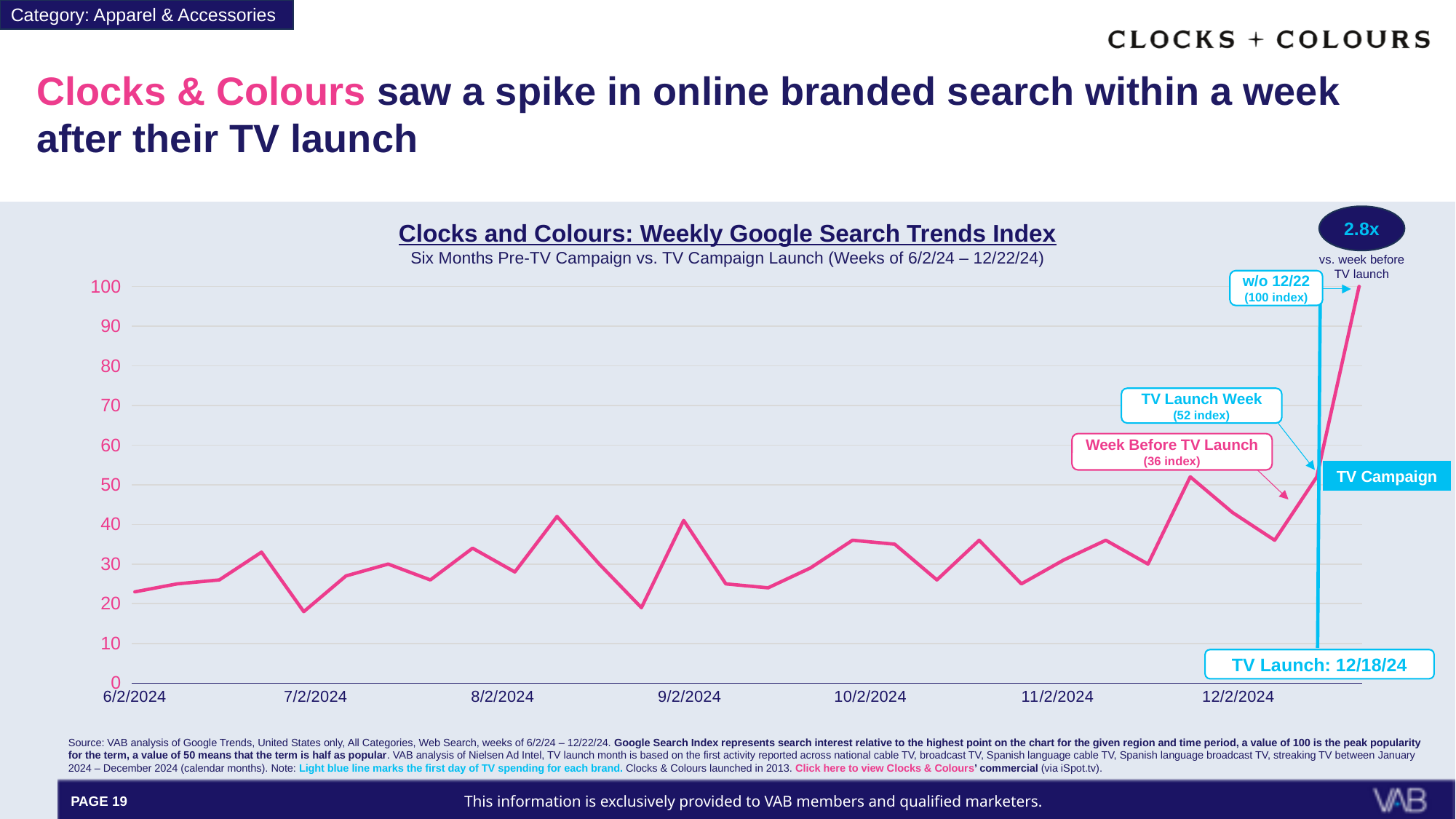
By how much does the TV Launch Week index exceed the Week Before TV Launch index? 16 What is the Google Search Trends index for the week of 12/22? 100 What kind of chart is shown on the slide? line chart Which week has the highest search index on the chart? w/o 12/22 What is the index value for the TV Launch Week? 52 What is the TV launch date marked on the chart? 12/18/24 Does the index rise or fall from the Week Before TV Launch to the week of 12/22? rises Which is larger, the index for the TV Launch Week or the Week Before TV Launch? TV Launch Week By what multiple did search increase vs. the week before TV launch, according to the callout? 2.8x What is the index value for the Week Before TV Launch? 36 Is the index value for 6/2/2024 greater or less than 30? less What is the difference between the index for the week of 12/22 and the Week Before TV Launch? 64